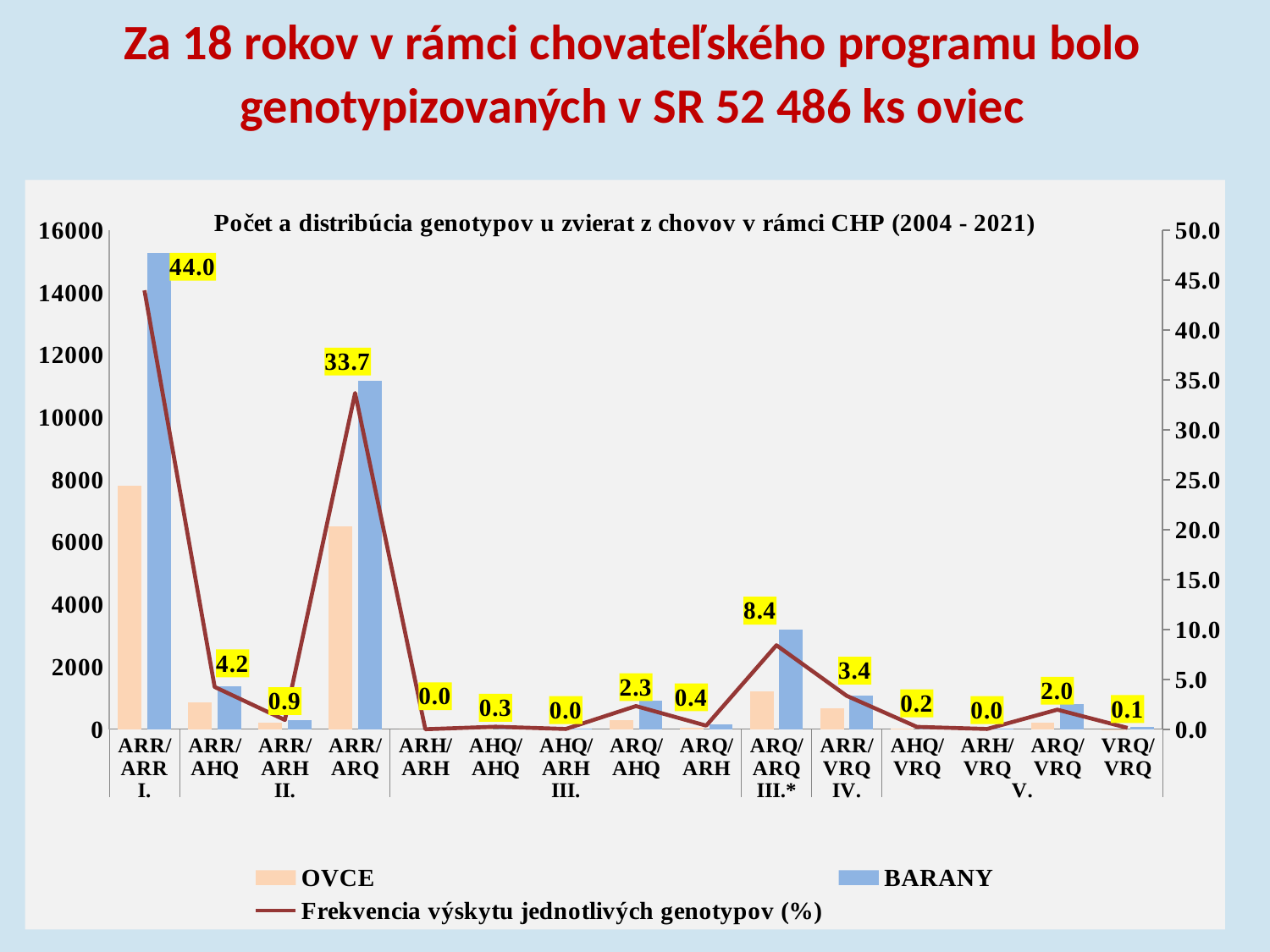
How many series does the legend list? 3 What is the frequency (%) value labelled for ARR/ARR? 44.0 Is the BARANY value for ARR/ARR greater or less than 14000? greater What is the difference between the frequency values for ARR/ARR and ARR/ARQ? 10.3 What is the frequency (%) value labelled for ARQ/ARQ? 8.4 Which has a larger frequency value, ARR/AHQ or ARR/VRQ? ARR/AHQ Which series is drawn as a line rather than bars? Frekvencia výskytu jednotlivých genotypov (%) What is the chart title? Počet a distribúcia genotypov u zvierat z chovov v rámci CHP (2004 - 2021) Is the BARANY value for ARR/ARQ greater or less than 10000? greater How many genotype categories are shown on the x axis? 15 Which genotype has the highest frequency (%) value? ARR/ARR What is the frequency (%) value labelled for ARR/ARQ? 33.7